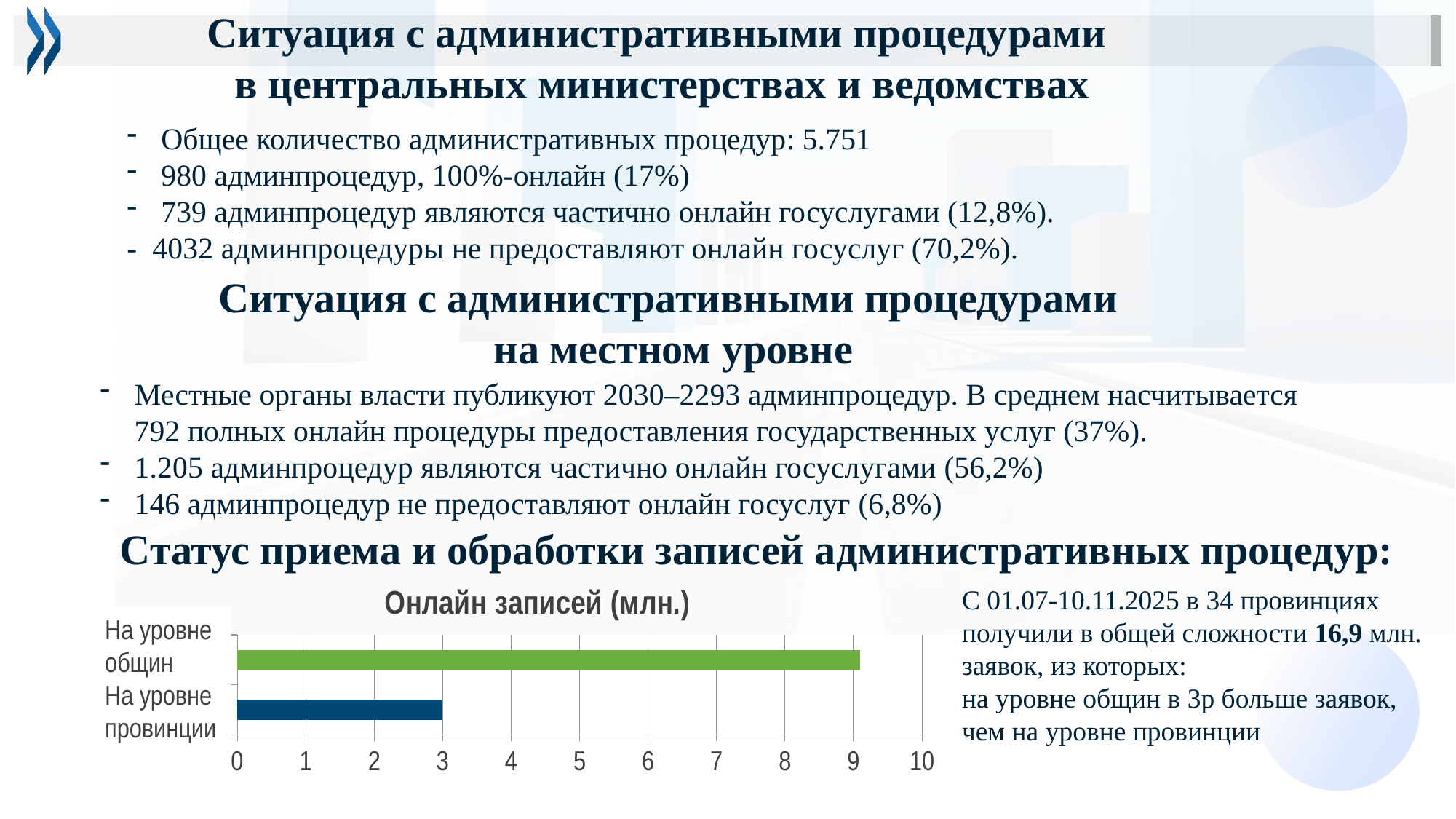
What is the title of the bar chart on the slide? Онлайн записей (млн.) What kind of chart is shown under "Статус приема и обработки записей административных процедур"? bar chart In the chart "Онлайн записей (млн.)", which is larger: the value for "На уровне общин" or for "На уровне провинции"? На уровне общин What is the maximum value shown on the x axis of the chart "Онлайн записей (млн.)"? 10 How many categories does the bar chart "Онлайн записей (млн.)" show? 2 In the chart "Онлайн записей (млн.)", what colour is the bar for "На уровне общин"? green In the chart "Онлайн записей (млн.)", is the value for "На уровне провинции" greater or less than 4? less In the chart "Онлайн записей (млн.)", which category has the highest value? На уровне общин In the chart "Онлайн записей (млн.)", is the value for "На уровне общин" greater or less than 8? greater In the chart "Онлайн записей (млн.)", which category has the lowest value? На уровне провинции In the chart "Онлайн записей (млн.)", what is the value for "На уровне провинции"? 3 In the chart "Онлайн записей (млн.)", is the value for "На уровне общин" greater or less than 5? greater